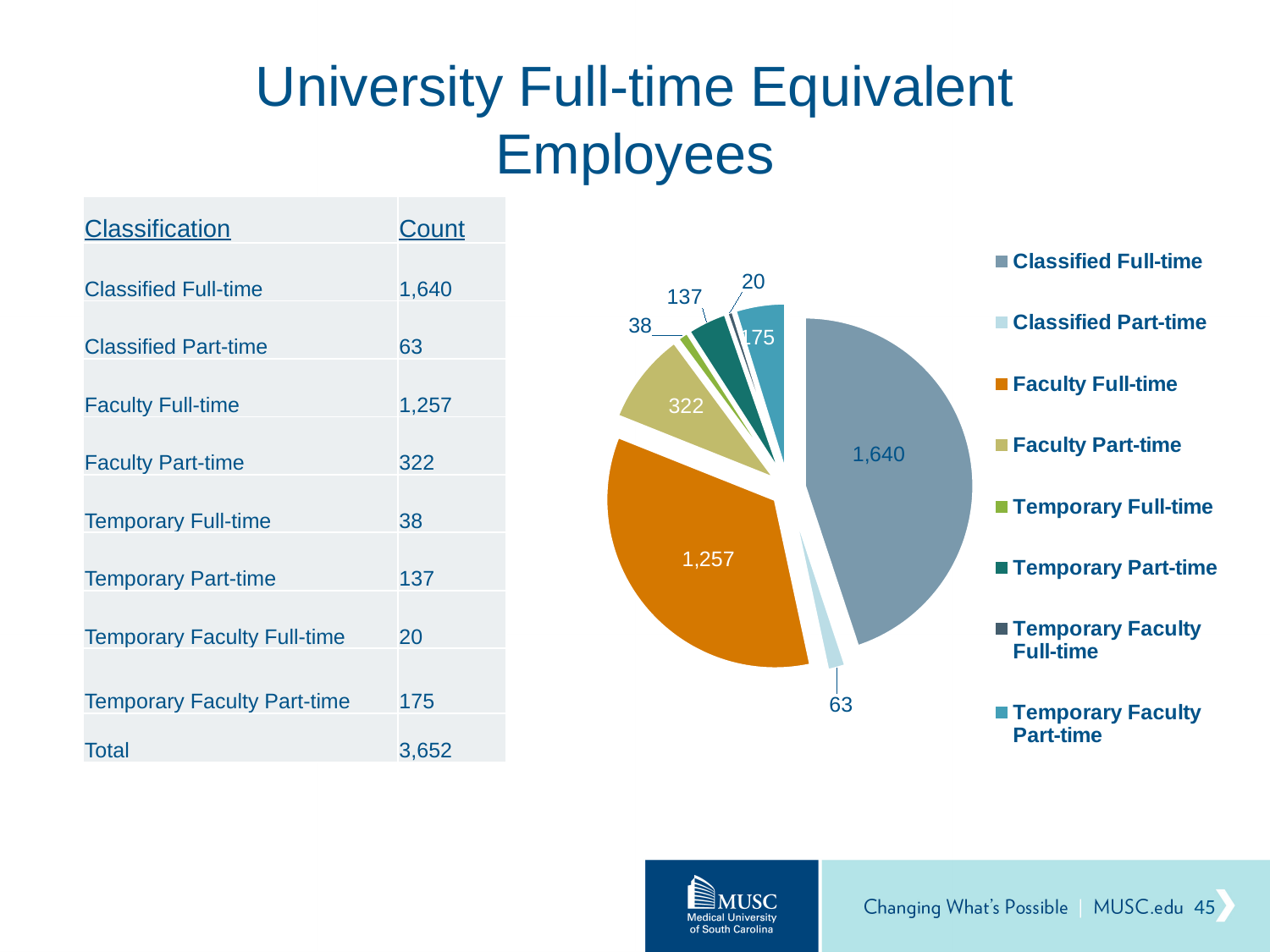
What is the value of the Faculty Part-time slice in the pie chart? 322 Which category has the smallest slice in the pie chart? Temporary Faculty Full-time What is the difference between the Faculty Part-time and Temporary Faculty Part-time values in the pie chart? 147 What is the value of the Temporary Faculty Full-time slice in the pie chart? 20 Which is larger in the pie chart, Temporary Part-time or Classified Part-time? Temporary Part-time How many slices does the pie chart have? 8 What is the value of the Temporary Part-time slice in the pie chart? 137 How many entries does the pie chart's legend list? 8 What is the value of the Classified Full-time slice in the pie chart? 1,640 What type of chart is shown on the slide? pie chart What is the difference between the Classified Full-time and Faculty Full-time values in the pie chart? 383 Which category has the largest slice in the pie chart? Classified Full-time